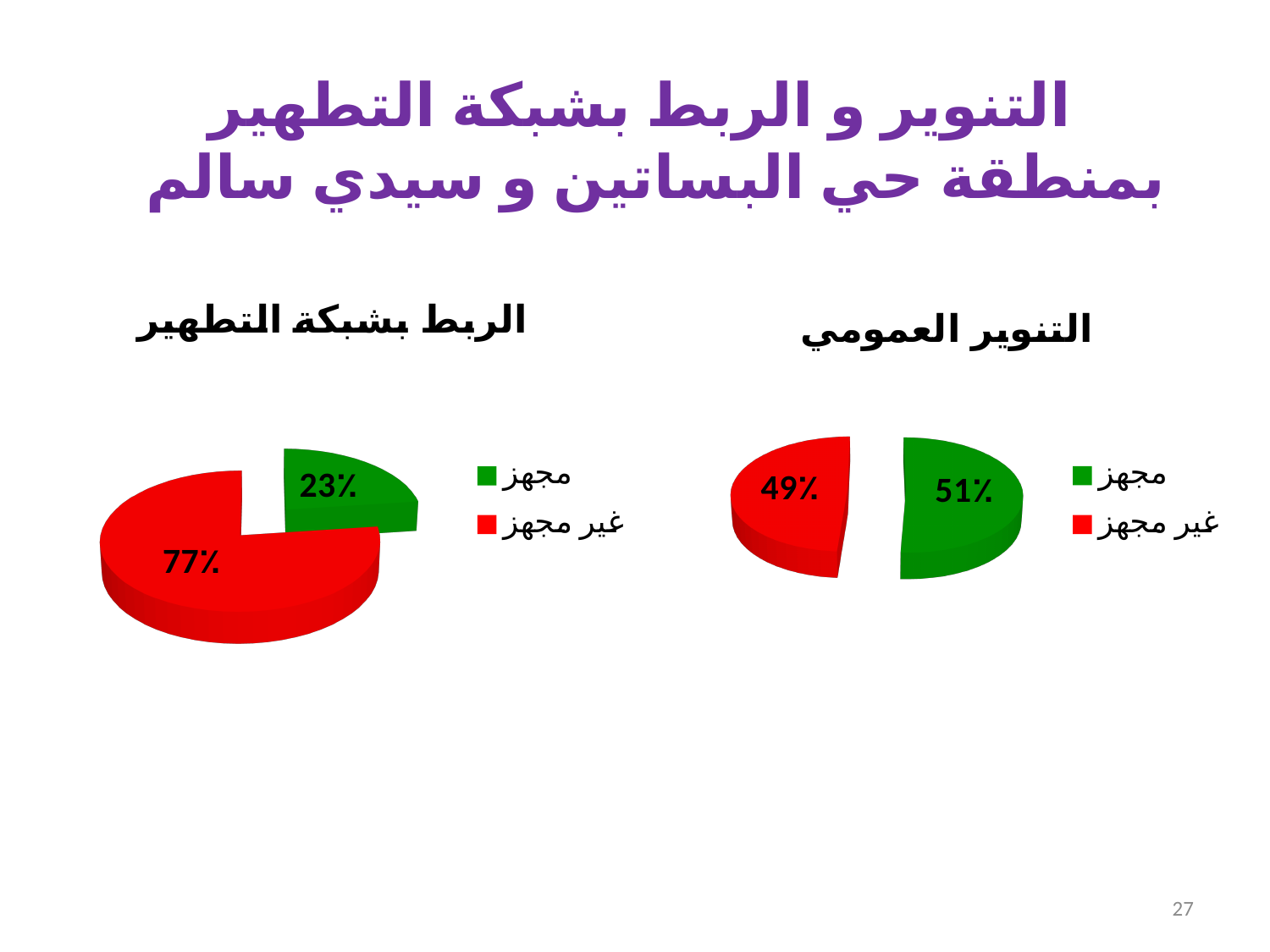
In the chart titled "الربط بشبكة التطهير", what is the difference between the "غير مجهز" and "مجهز" percentages? 54% What type of chart is the chart titled "الربط بشبكة التطهير"? Pie chart In the chart titled "الربط بشبكة التطهير", what percentage is shown for "غير مجهز"? 77% In the chart titled "الربط بشبكة التطهير", which slice is the largest? غير مجهز In the chart titled "التنوير العمومي", what is the difference between the "مجهز" and "غير مجهز" percentages? 2% How many slices does the chart titled "التنوير العمومي" have? 2 In the chart titled "التنوير العمومي", what percentage is shown for "مجهز"? 51% In the chart titled "الربط بشبكة التطهير", what percentage is shown for "مجهز"? 23% In the chart titled "الربط بشبكة التطهير", which slice is the smallest? مجهز In the chart titled "التنوير العمومي", what colour is the "غير مجهز" slice? Red Is the "مجهز" share larger in the chart titled "التنوير العمومي" or in the chart titled "الربط بشبكة التطهير"? التنوير العمومي In the chart titled "التنوير العمومي", what percentage is shown for "غير مجهز"? 49%